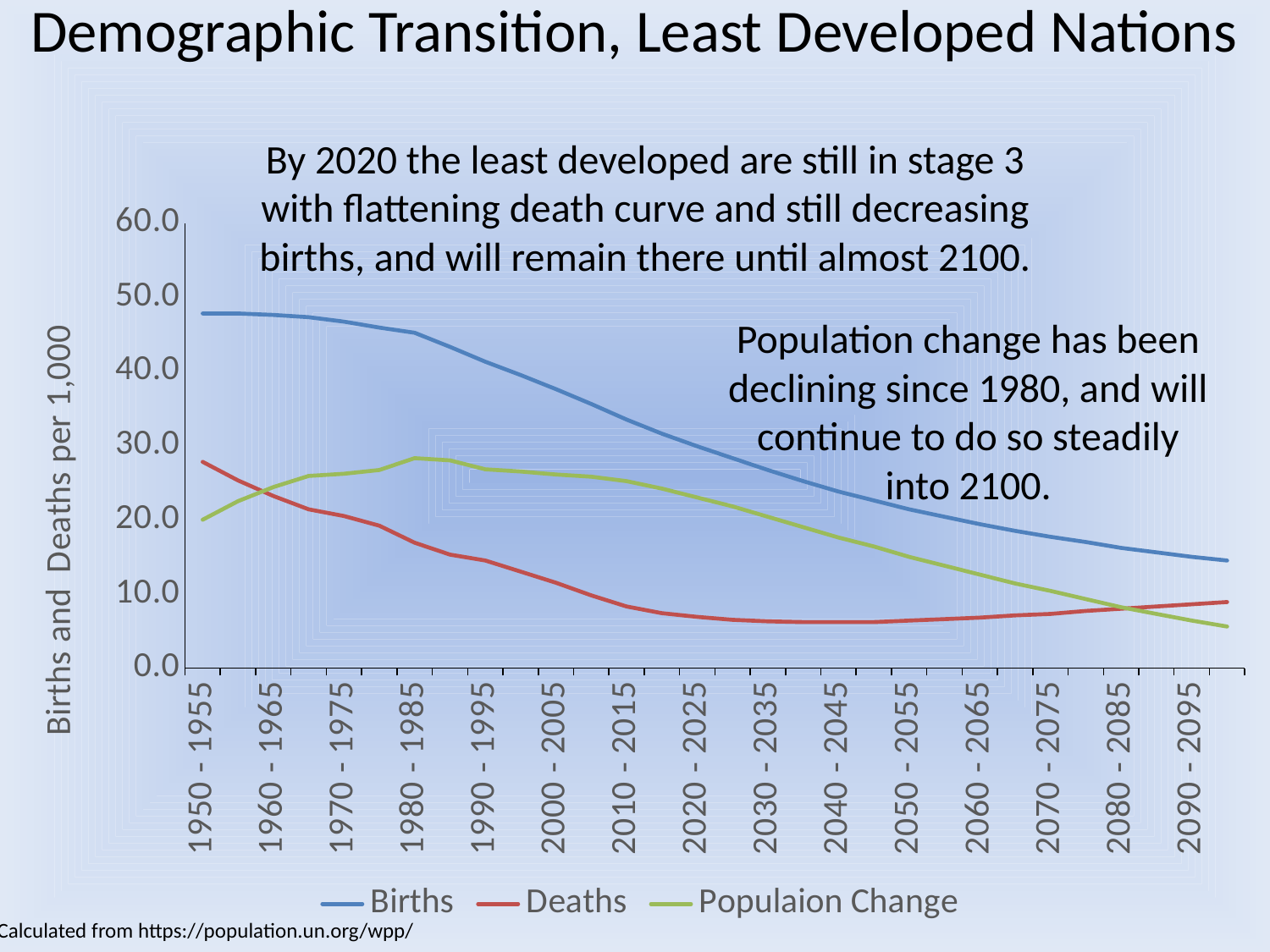
Is the value for Deaths in 1950 - 1955 greater or less than 20.0? greater Which series has the highest value in 1950 - 1955? Births Do the values for Births rise or fall from 1950 - 1955 to 2090 - 2095? fall Is the value for Births in 2090 - 2095 greater or less than 20.0? less Is the value for Deaths in 2040 - 2045 greater or less than 10.0? less What is the title of the vertical axis? Births and Deaths per 1,000 How many series does the legend list? 3 What kind of chart is shown on the slide? line chart Which series has the lowest value in 2040 - 2045? Deaths Which series is plotted with the blue line? Births